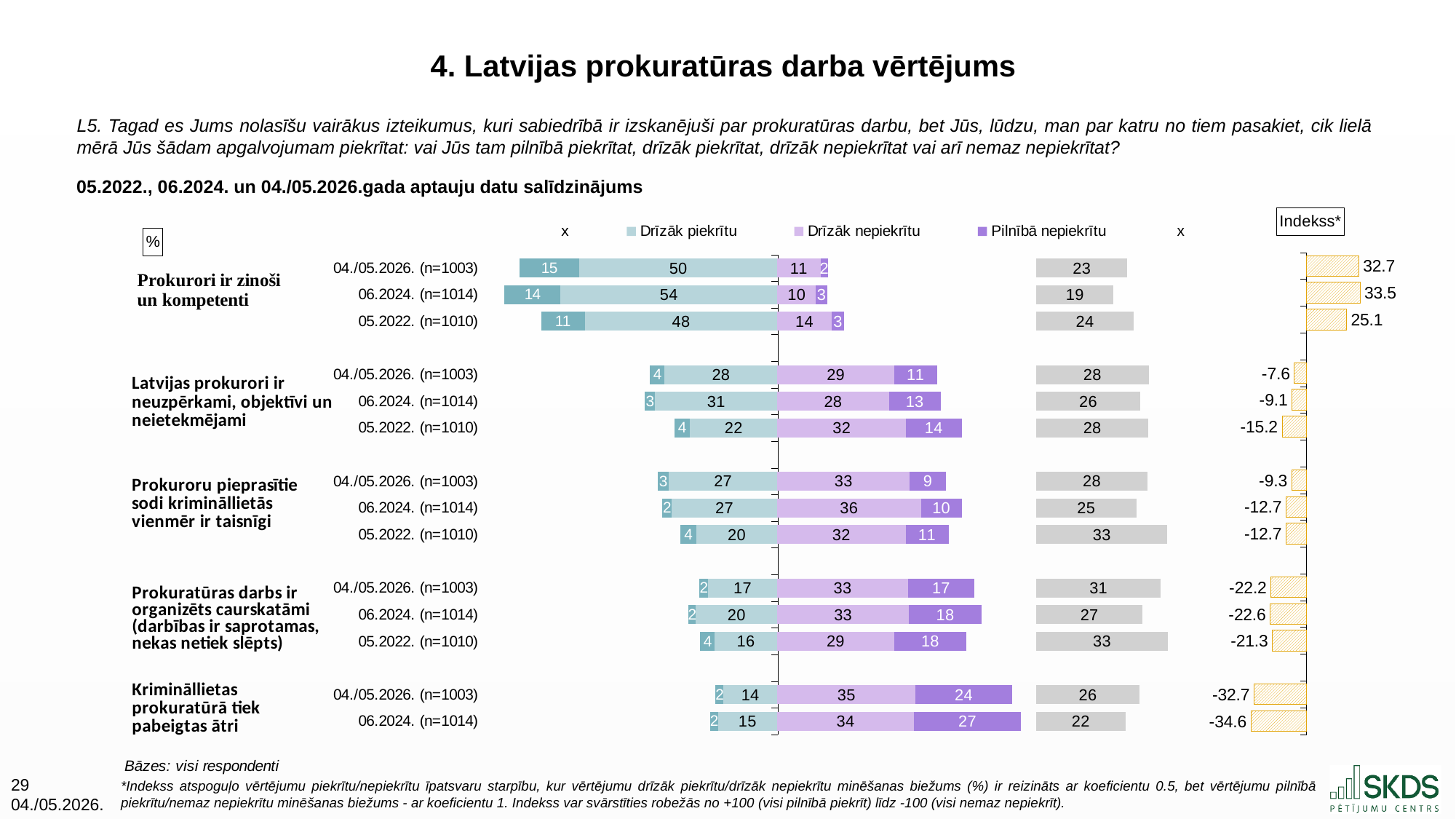
What is the Indekss* value for 'Prokurori ir zinoši un kompetenti' in 04./05.2026. (n=1003)? 32.7 What is the 'Drīzāk nepiekrītu' value for 'Latvijas prokurori ir neuzpērkami, objektīvi un neietekmējami' in 04./05.2026. (n=1003)? 29 What type of chart is shown on the slide? Stacked bar chart Which statement and survey wave has the lowest Indekss* value? Krimināllietas prokuratūrā tiek pabeigtas ātri, 06.2024. (-34.6) What is the 'Drīzāk piekrītu' value for 'Prokurori ir zinoši un kompetenti' in 06.2024. (n=1014)? 54 What is the 'Pilnībā nepiekrītu' value for 'Krimināllietas prokuratūrā tiek pabeigtas ātri' in 06.2024. (n=1014)? 27 What is the sample size (n) for the 05.2022. survey wave? 1010 What is the difference between the 'Drīzāk nepiekrītu' values for 'Prokuroru pieprasītie sodi krimināllietās vienmēr ir taisnīgi' in 06.2024. and 04./05.2026.? 3 What is the Indekss* value for 'Latvijas prokurori ir neuzpērkami, objektīvi un neietekmējami' in 05.2022. (n=1010)? -15.2 For 'Prokuratūras darbs ir organizēts caurskatāmi', is the 'Drīzāk piekrītu' value larger in 06.2024. or in 04./05.2026.? 06.2024. Which statement and survey wave has the highest Indekss* value? Prokurori ir zinoši un kompetenti, 06.2024. (33.5) How many statements are evaluated in the chart? 5